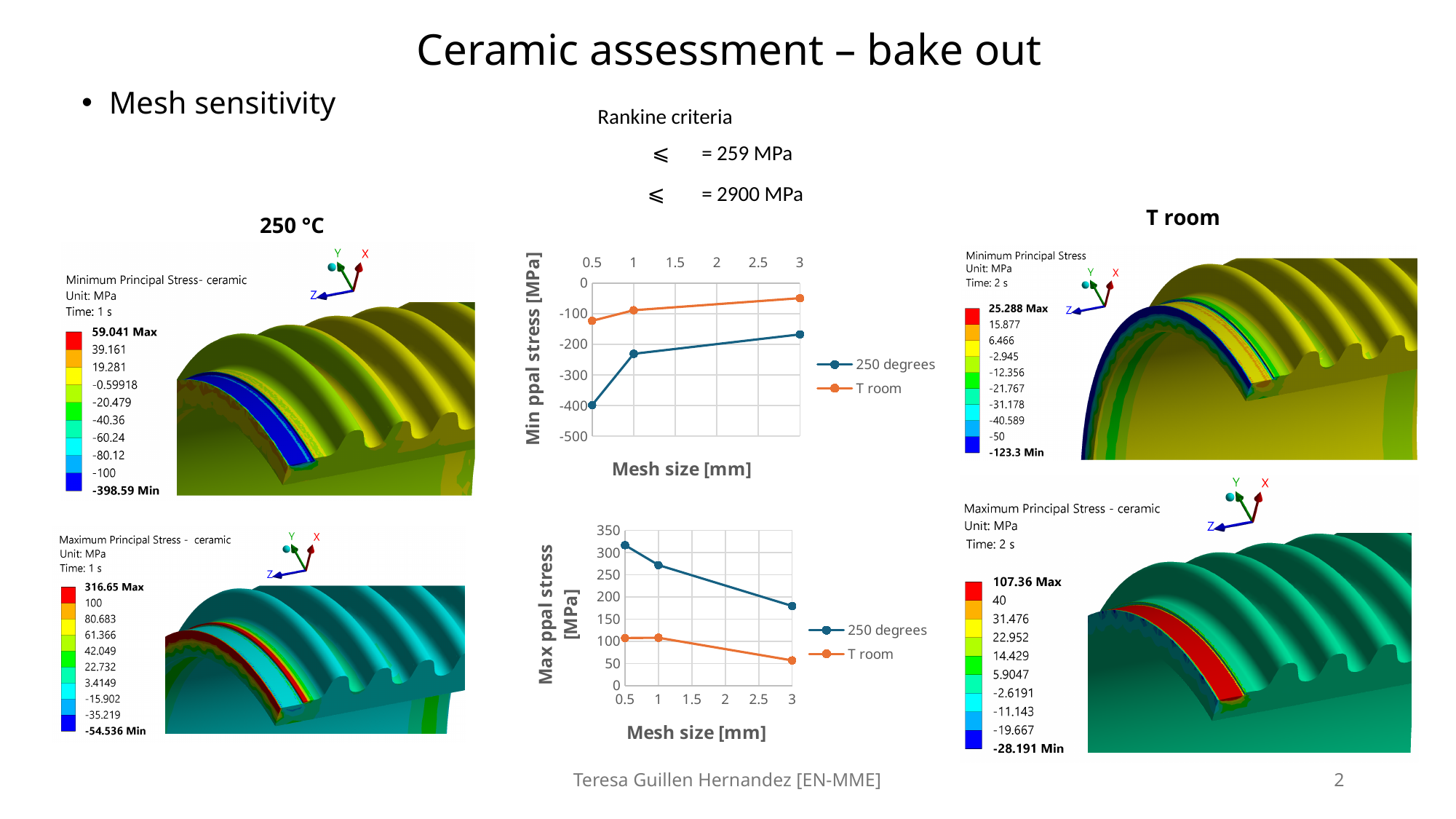
What kind of chart is the top chart titled 'Min ppal stress [MPa]'? line chart How many series does the legend of the bottom chart ('Max ppal stress [MPa]') list? 2 In the bottom chart ('Max ppal stress [MPa]'), at which mesh size is the '250 degrees' series highest? 0.5 What is the x-axis title of the bottom chart ('Max ppal stress [MPa]')? Mesh size [mm] In the top chart ('Min ppal stress [MPa]'), at which mesh size is the '250 degrees' series lowest? 0.5 In the top chart ('Min ppal stress [MPa]'), do the values of the '250 degrees' series rise or fall as mesh size increases? rise In the top chart ('Min ppal stress [MPa]'), is the '250 degrees' value at mesh size 0.5 greater or less than -300? less In the top chart ('Min ppal stress [MPa]'), how many data points does the '250 degrees' series have? 3 In the bottom chart ('Max ppal stress [MPa]'), do the values of the '250 degrees' series rise or fall as mesh size increases? fall In the bottom chart ('Max ppal stress [MPa]'), is the '250 degrees' value at mesh size 0.5 greater or less than 300? greater In the bottom chart ('Max ppal stress [MPa]'), is the 'T room' value at mesh size 3 greater or less than 100? less In the bottom chart ('Max ppal stress [MPa]'), which series has the larger value at mesh size 3, '250 degrees' or 'T room'? 250 degrees